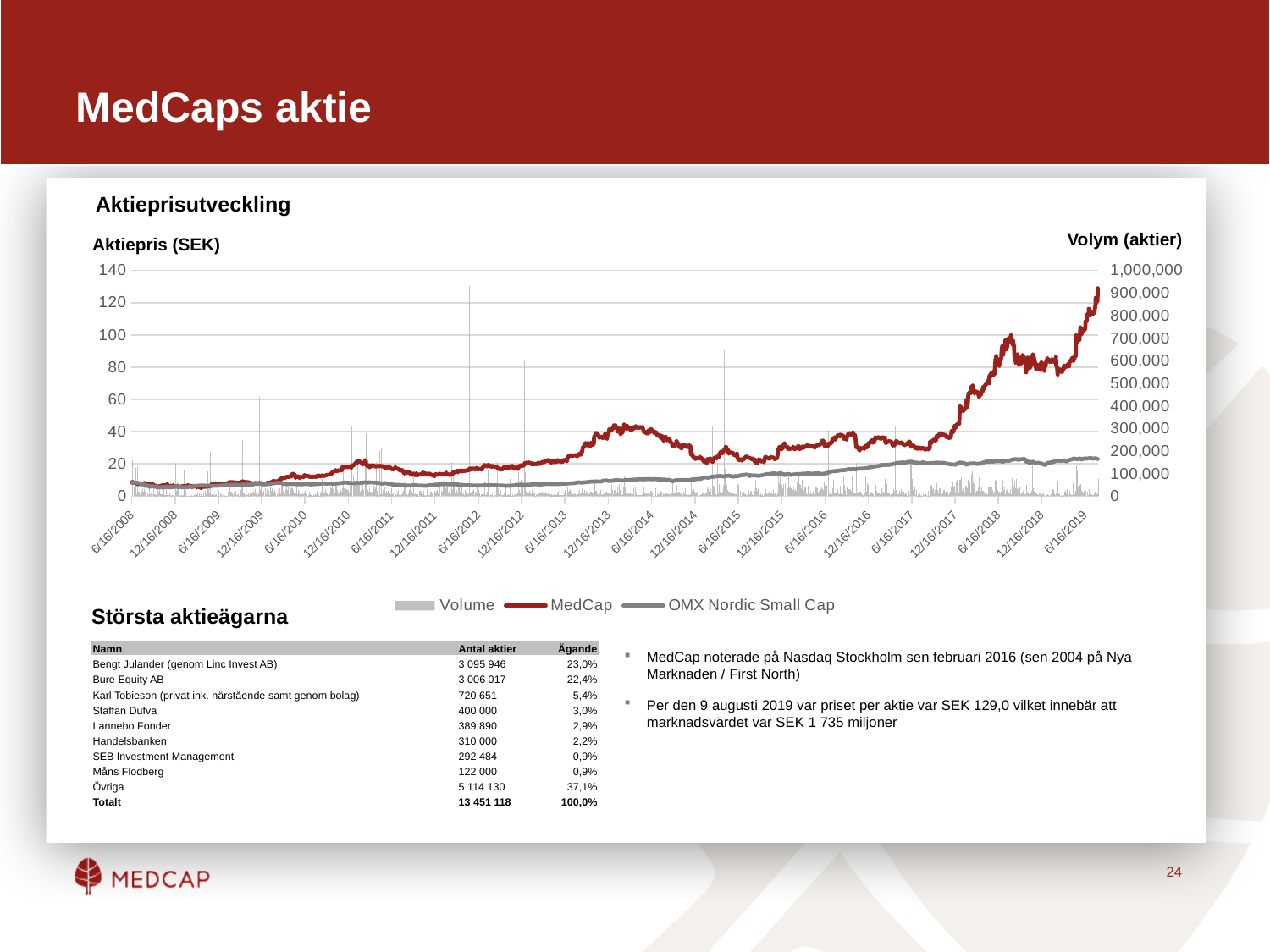
What are the three entries in the legend of the Aktieprisutveckling chart? Volume, MedCap, OMX Nordic Small Cap What is the title of the left vertical axis of the Aktieprisutveckling chart? Aktiepris (SEK) Which series reaches the highest share price value in the Aktieprisutveckling chart? MedCap In the Aktieprisutveckling chart, is the MedCap value at 6/16/2008 greater or less than 20? less What is the highest tick value shown on the right (Volym) axis of the Aktieprisutveckling chart? 1,000,000 In the Aktieprisutveckling chart, does the MedCap line rise or fall between 6/16/2017 and 6/16/2019? rises In the Aktieprisutveckling chart, is the OMX Nordic Small Cap value at 6/16/2019 greater or less than 40? less In the Aktieprisutveckling chart, which series is higher at 6/16/2019, MedCap or OMX Nordic Small Cap? MedCap How many series does the legend of the Aktieprisutveckling chart list? 3 What kind of chart is used to plot the MedCap and OMX Nordic Small Cap series in the Aktieprisutveckling chart? line chart What is the highest tick value shown on the left axis of the Aktieprisutveckling chart? 140